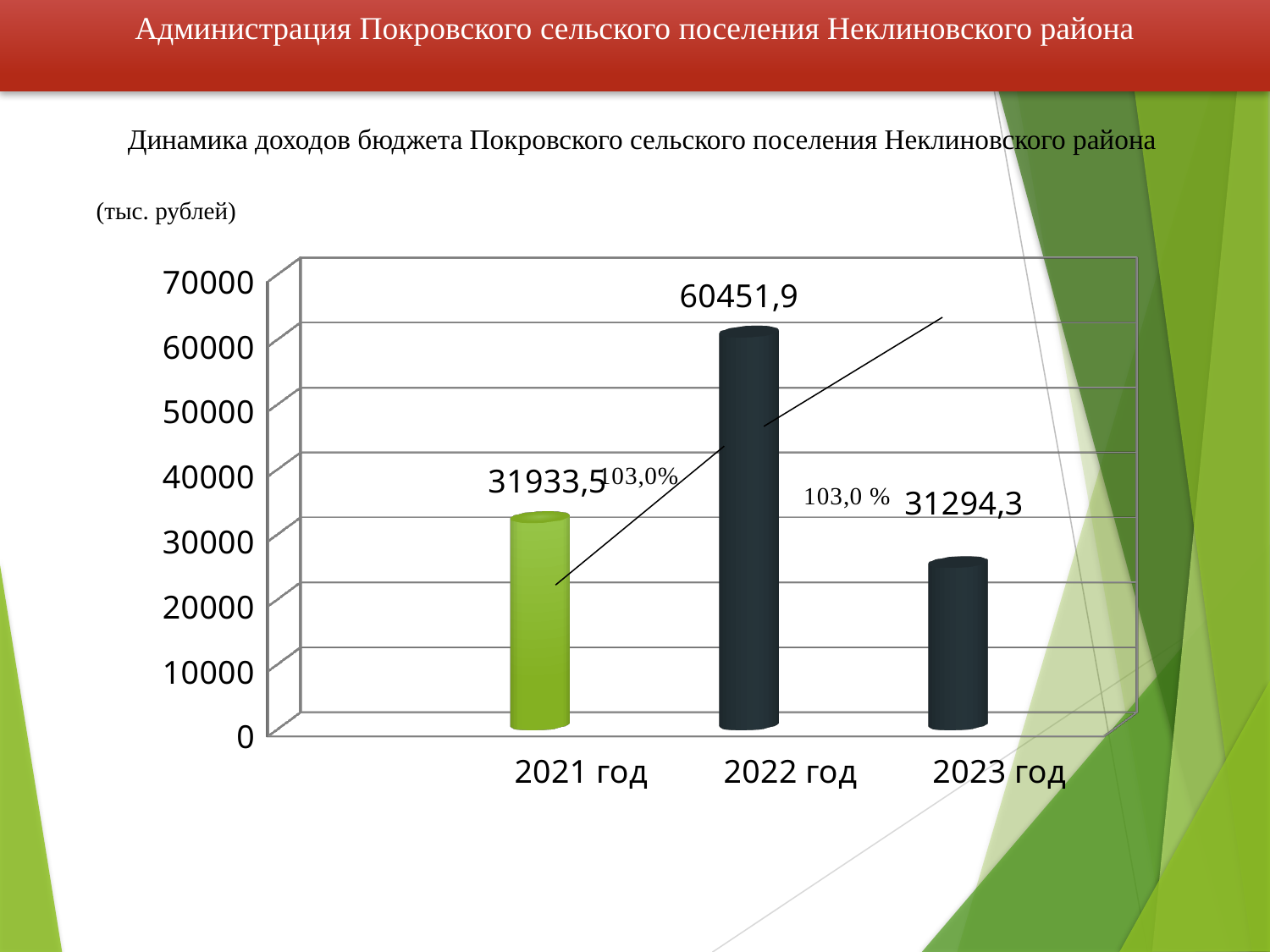
Which is larger, the value for 2021 год or the value for 2023 год? 2021 год What is the budget revenue value shown for 2023 год? 31294,3 What unit of measurement is stated for the chart values? тыс. рублей Which year has the lowest budget revenue on the chart? 2023 год What is the difference between the values for 2022 год and 2021 год? 28518,4 Which year has the highest budget revenue on the chart? 2022 год Is the value for 2022 год greater or less than 50000? greater What kind of chart is shown on the slide? bar chart What is the budget revenue value shown for 2021 год? 31933,5 How many years (categories) are shown on the chart? 3 What is the budget revenue value shown for 2022 год? 60451,9